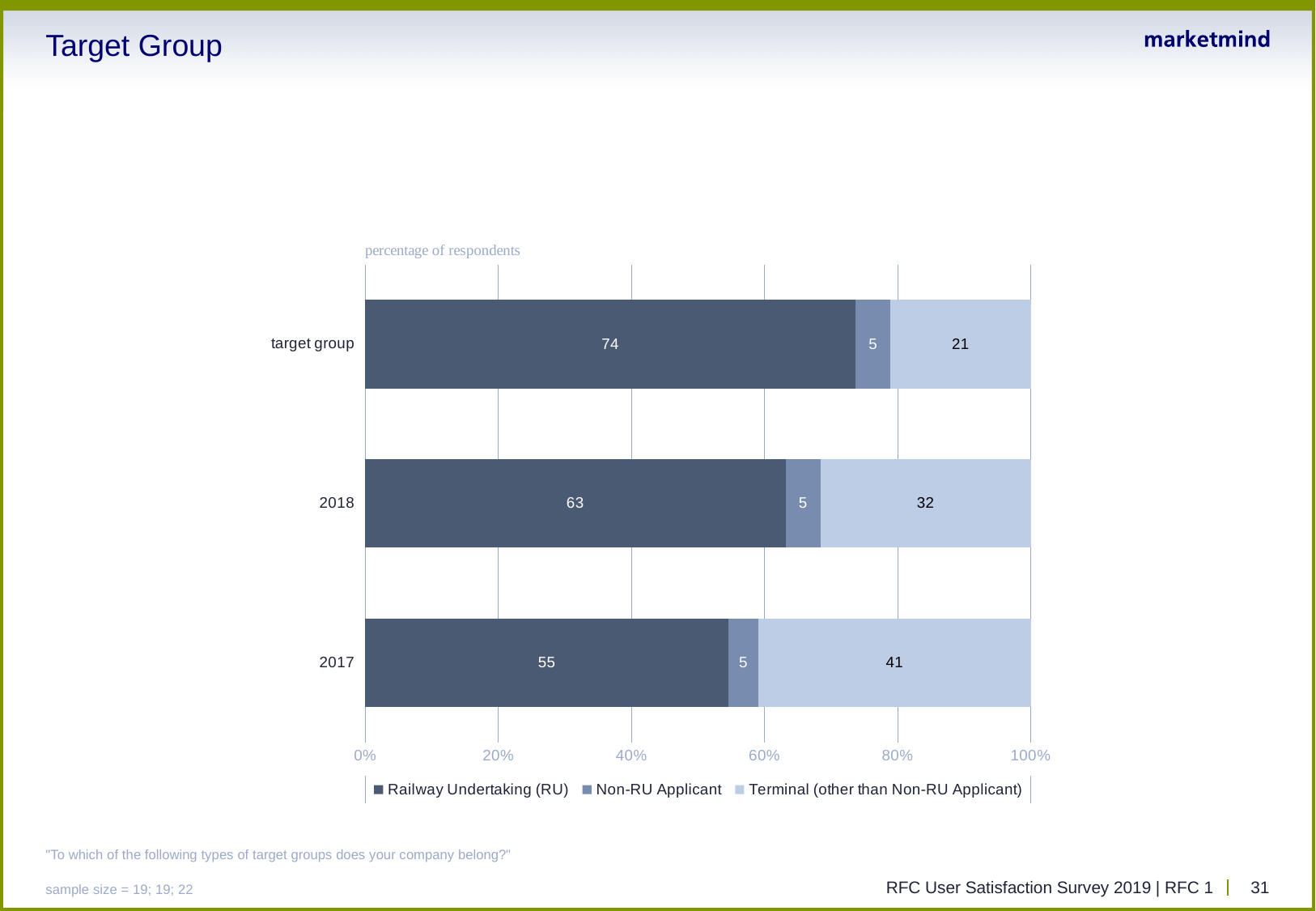
What is the difference between the Railway Undertaking (RU) values for 2018 and 2017? 8 What is the total of the 2018 bar? 100 How many series does the legend list? 3 What kind of chart is shown on the slide? stacked bar chart How many bars are shown in the chart? 3 What is the value for Non-RU Applicant in 2018? 5 Which is larger: the Terminal (other than Non-RU Applicant) value in 2018 or in 2017? 2017 What is the axis label shown above the chart? percentage of respondents Which bar has the lowest value for Terminal (other than Non-RU Applicant)? target group Which bar has the highest value for Railway Undertaking (RU)? target group What is the value for Terminal (other than Non-RU Applicant) in 2017? 41 What is the value for Railway Undertaking (RU) in the target group bar? 74